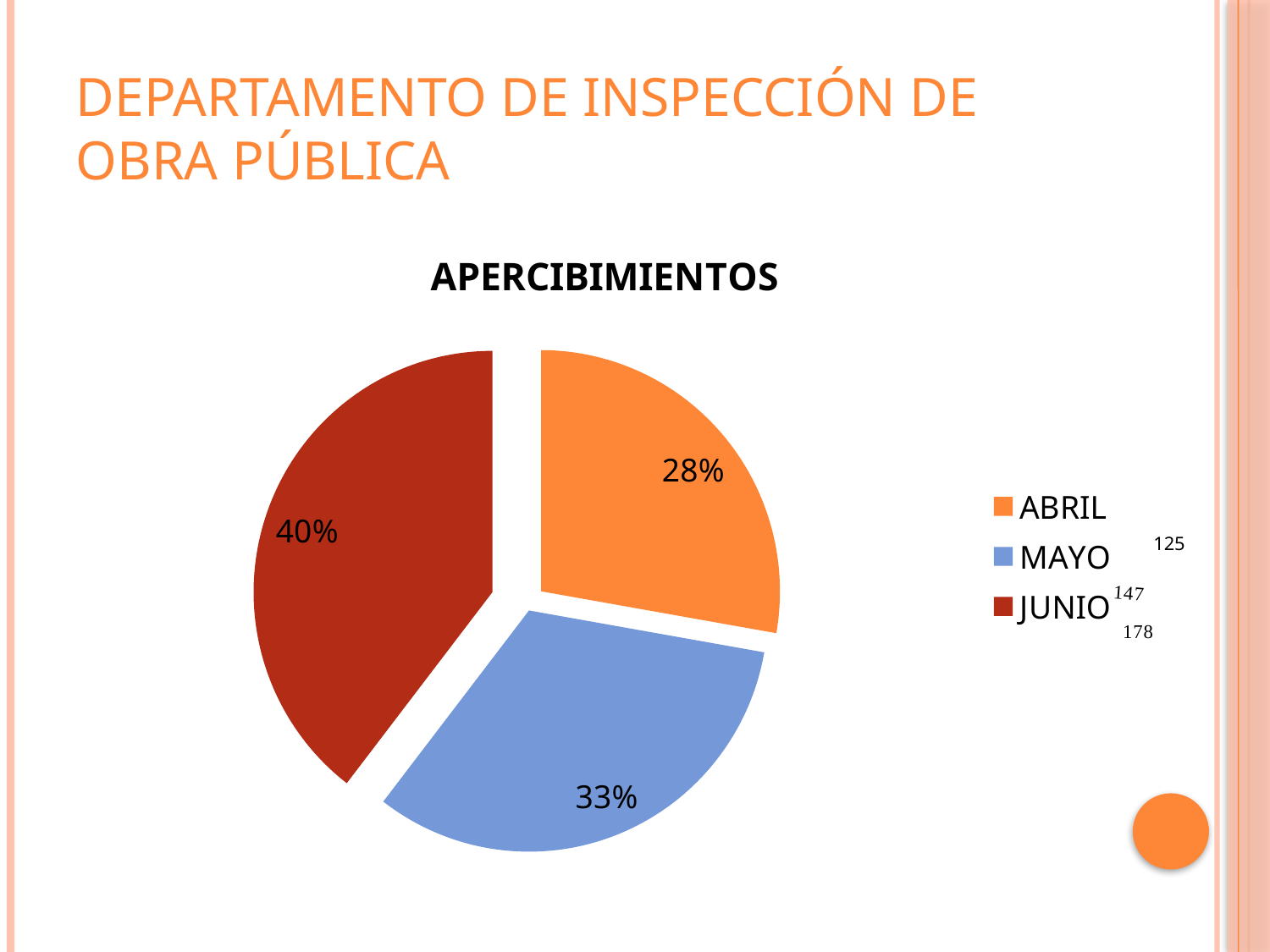
Which month has the smallest slice of the pie? ABRIL Which slice is larger, MAYO or ABRIL? MAYO By how many percentage points does JUNIO's share exceed ABRIL's share? 12 percentage points Which month is shown in blue in the pie chart? MAYO How many slices does the pie chart have? 3 What is the title of the chart? APERCIBIMIENTOS What kind of chart is shown on the slide? Pie chart By how many percentage points does JUNIO's share exceed MAYO's share? 7 percentage points What share of the pie does ABRIL represent? 28% What share of the pie does MAYO represent? 33% What share of the pie does JUNIO represent? 40% Which month has the largest slice of the pie? JUNIO